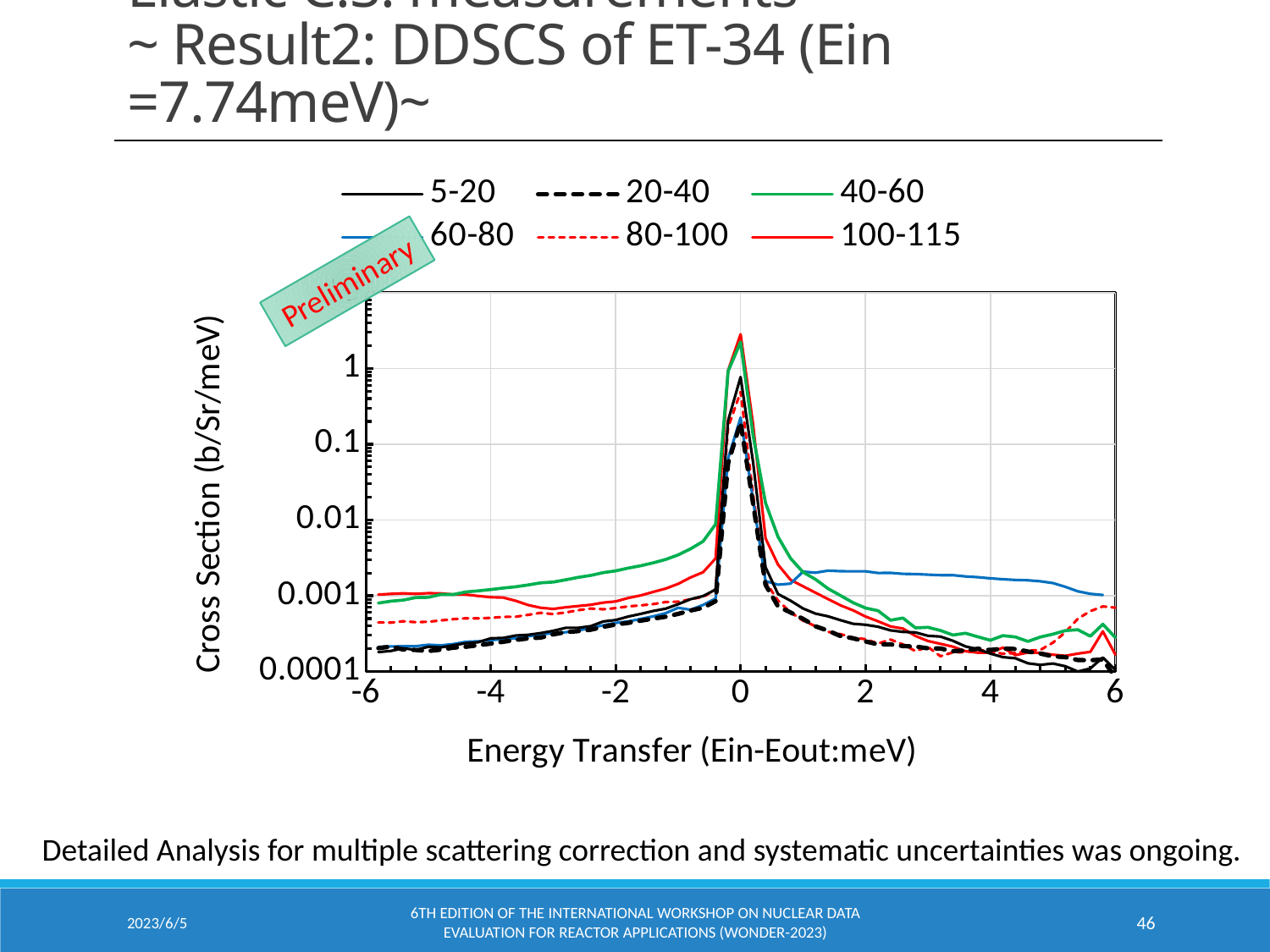
At an energy transfer of 2, which is larger: the 60-80 series or the 5-20 series? 60-80 What kind of chart is shown on the slide? line chart What is the title of the x axis? Energy Transfer (Ein-Eout:meV) For the 5-20 series, do the values rise or fall as the energy transfer goes from -6 to 0? rise Which series has the highest value at an energy transfer of 2? 60-80 At an energy transfer of -6, is the value for the 80-100 series greater or less than 0.001? less At an energy transfer of 0, is the value for the 5-20 series greater or less than 0.1? greater At an energy transfer of -6, is the value for the 5-20 series greater or less than 0.001? less What is the title of the y axis? Cross Section (b/Sr/meV) How many series does the legend list? 6